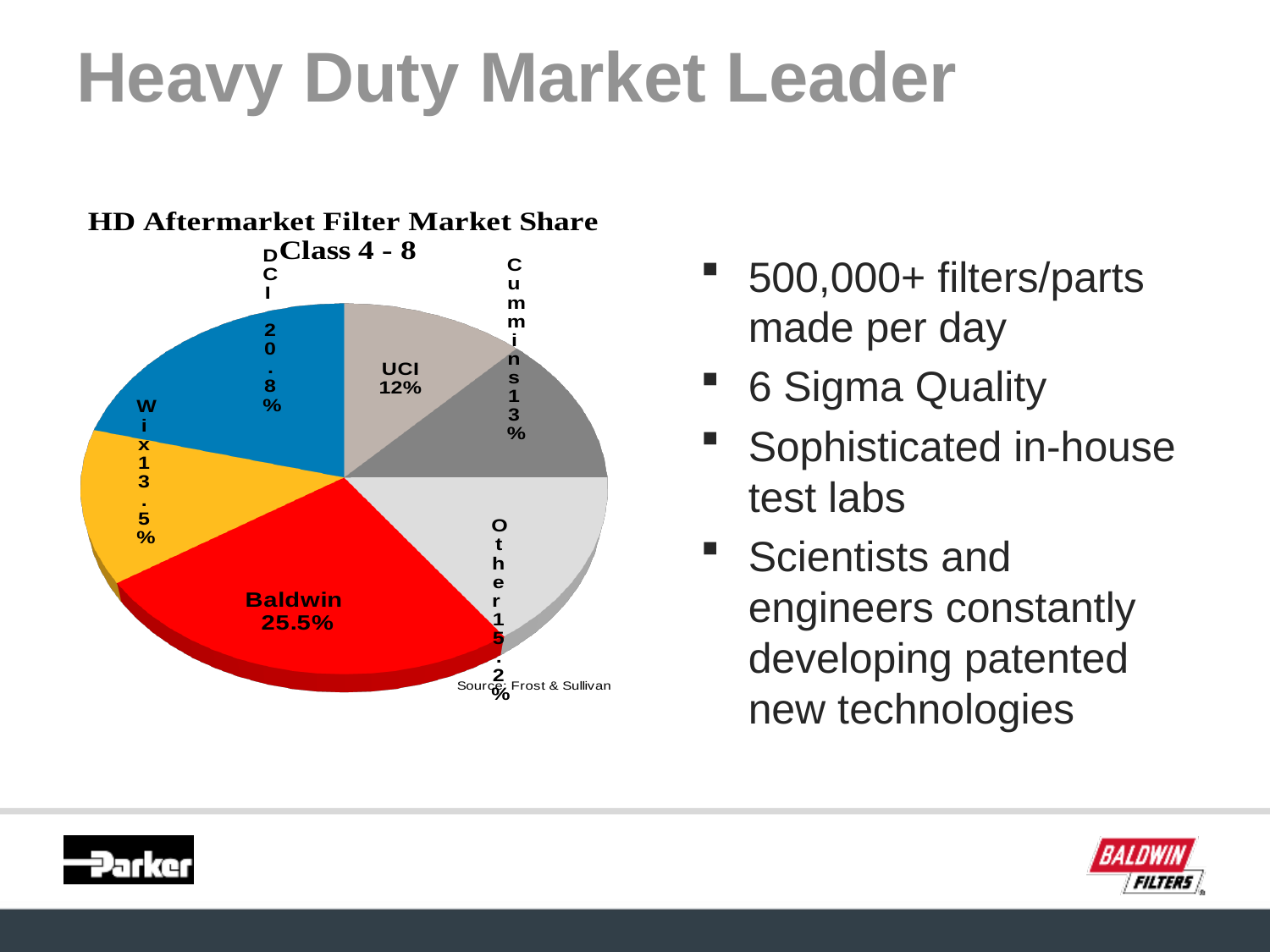
How many percentage points larger is Baldwin's share than DCI's share? 4.7% What is the market share shown for Wix? 13.5% What is the market share shown for Cummins? 13% What share is shown for UCI in the pie chart? 12% What share is labelled for the Other slice? 15.2% What type of chart is shown on the slide? Pie chart Which slice of the pie chart is the smallest? UCI What is Baldwin's share in the HD Aftermarket Filter Market Share pie chart? 25.5% What share does DCI hold in the pie chart? 20.8% Which has the larger share, Wix or Cummins? Wix How many slices does the pie chart have? 6 Which company has the largest slice of the pie chart? Baldwin